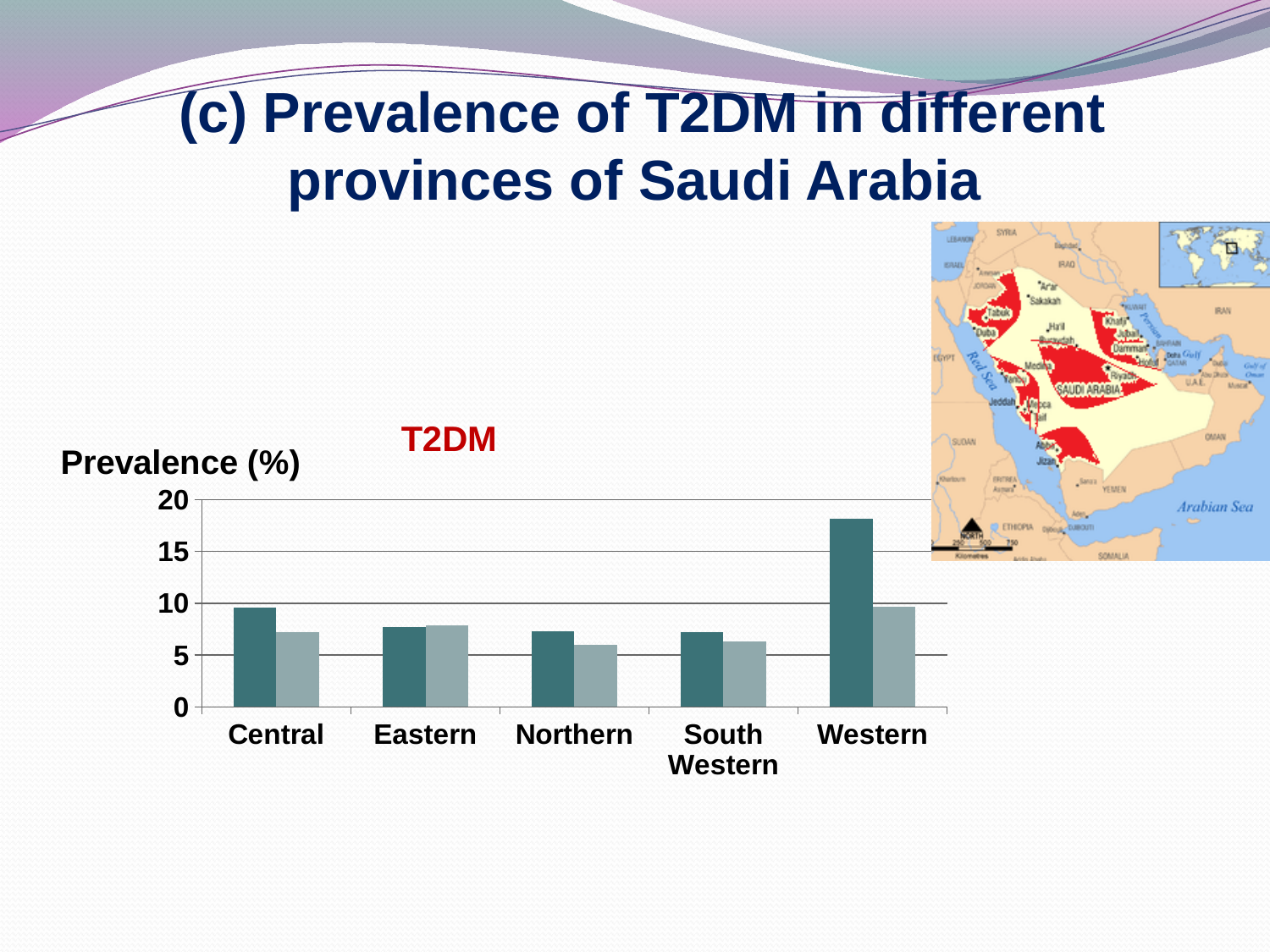
What kind of chart is shown on the slide? bar chart Which province has the highest light-coloured bar in the chart? Western Is the light-coloured bar for Northern greater or less than 5? greater Which province has the highest dark teal bar in the chart? Western How many provinces are shown on the x axis of the chart? 5 What is the title shown above the chart in red? T2DM What label is given to the vertical axis of the chart? Prevalence (%) Which is larger, the dark teal bar for Central or the light-coloured bar for Central? the dark teal bar Is the dark teal bar for Western greater or less than 15? greater Which is larger, the dark teal bar for Western or the dark teal bar for Central? Western Is the light-coloured bar for Western greater or less than 15? less